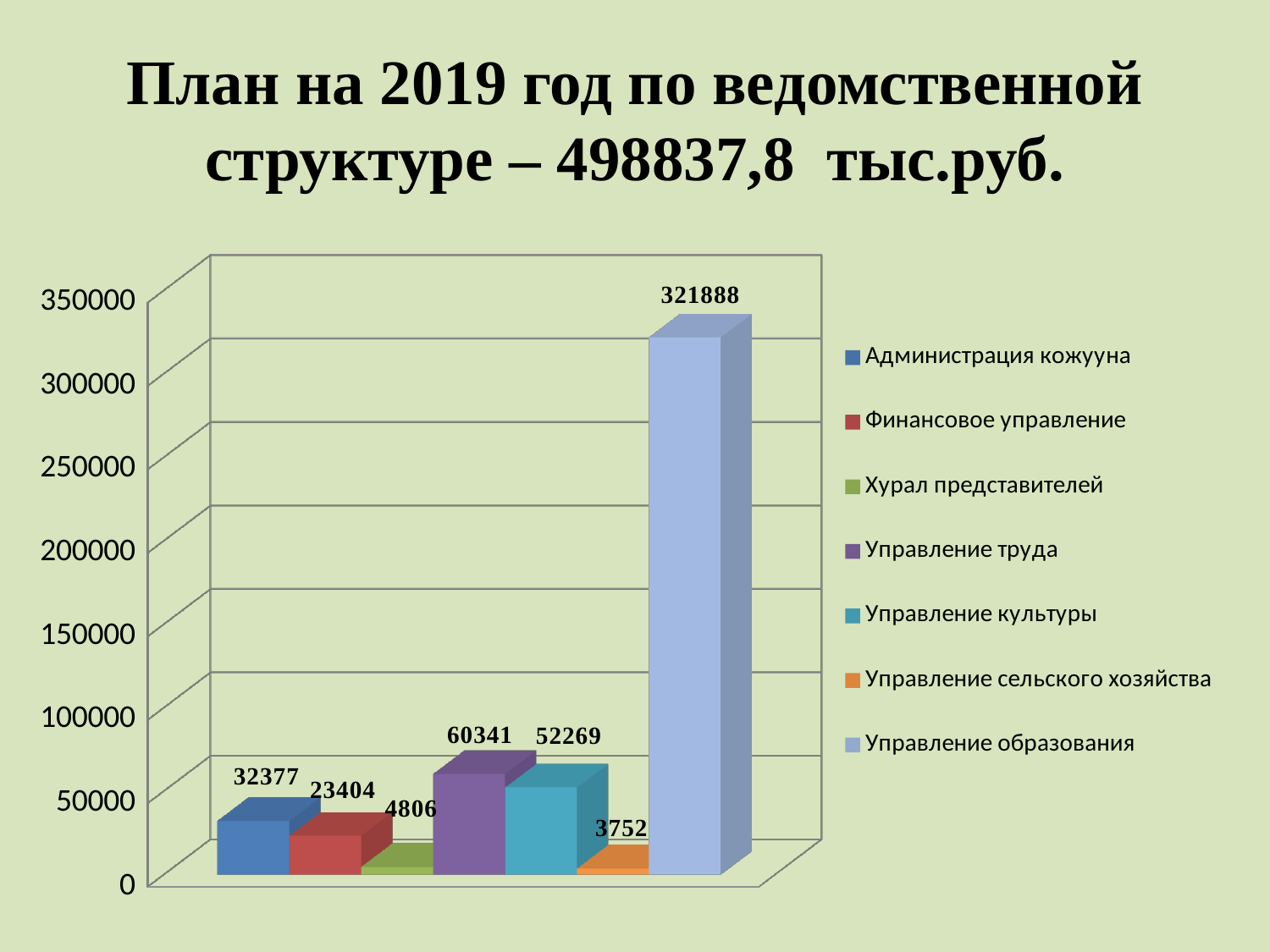
What is the value for Хурал представителей? 4806 What is the difference between the values for Управление труда and Управление культуры? 8072 What is the value for Администрация кожууна? 32377 How many series does the legend list? 7 What total amount is stated in the slide title? 498837,8 тыс.руб. Is the value for Управление образования greater or less than 300000? greater What is the value for Управление образования? 321888 Which series has the lowest value? Управление сельского хозяйства Which is larger, the value for Администрация кожууна or the value for Финансовое управление? Администрация кожууна What kind of chart is shown on the slide? bar chart What is the value for Управление культуры? 52269 Which series has the highest value? Управление образования